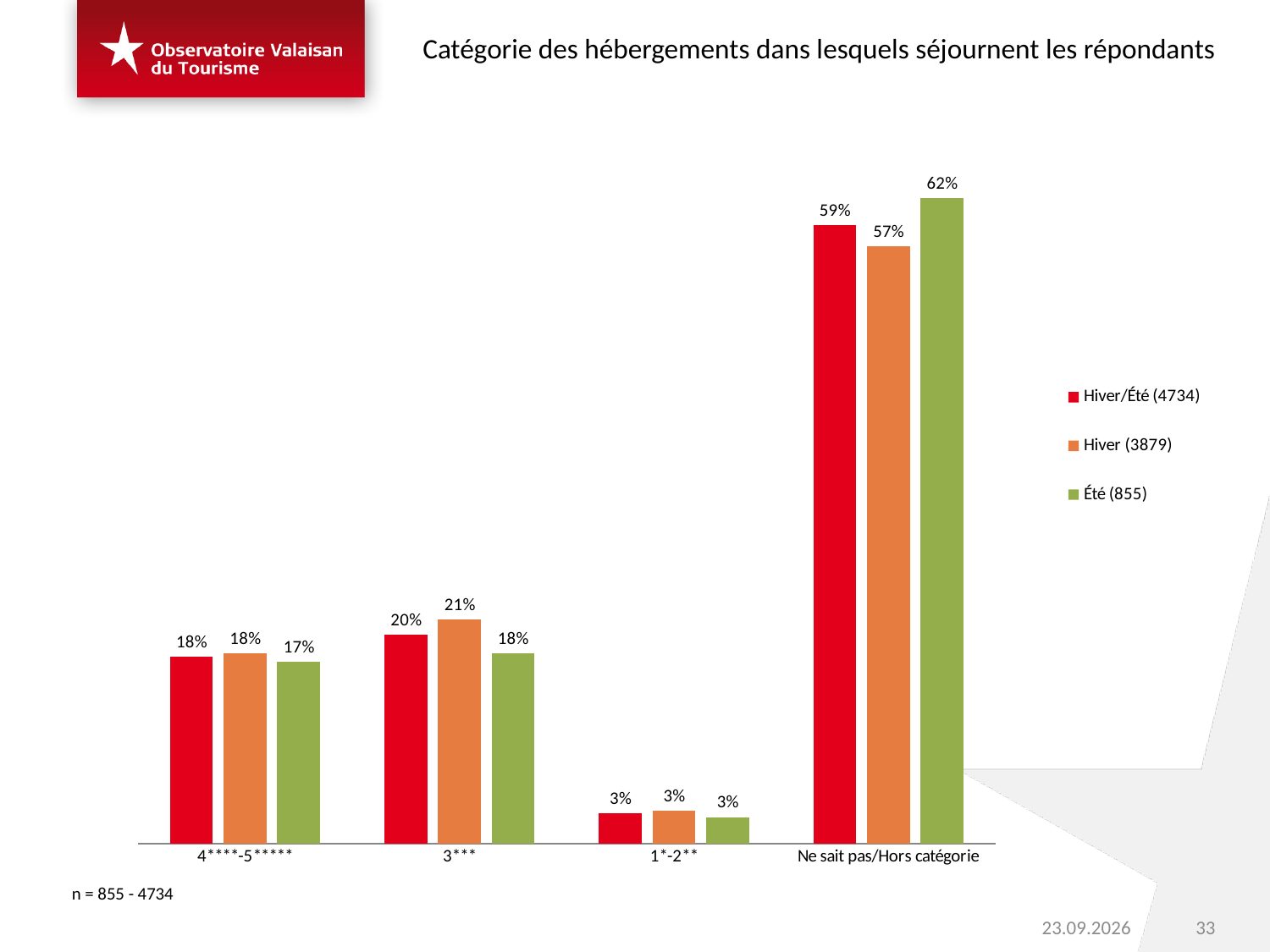
What is the value for Été (855) in the 'Ne sait pas/Hors catégorie' category? 62% What is the value for Hiver (3879) in the 3*** category? 21% Which category has the highest value for the Hiver/Été (4734) series? Ne sait pas/Hors catégorie Which category has the lowest value for the Été (855) series? 1*-2** What kind of chart is shown on the slide? Bar chart Which is larger in the 3*** category: the Hiver (3879) value or the Été (855) value? Hiver (3879) What is the difference between the Été (855) and Hiver (3879) values in the 'Ne sait pas/Hors catégorie' category? 5% Which colour represents the Été (855) series? Green How many categories are shown on the x axis? 4 What is the title of the chart? Catégorie des hébergements dans lesquels séjournent les répondants What is the value for Hiver/Été (4734) in the 4****-5***** category? 18% How many series does the legend list? 3